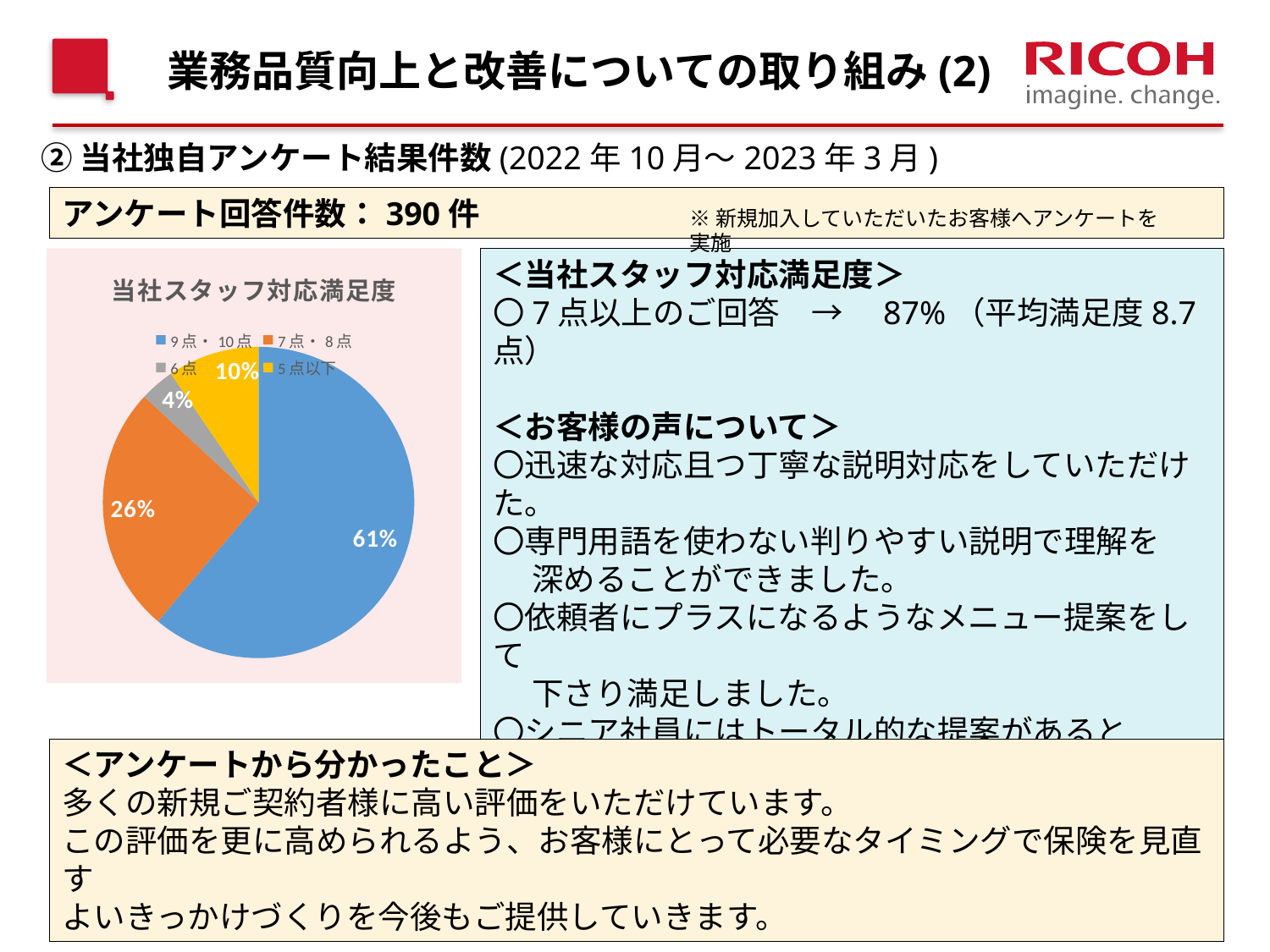
What share of the pie does the 9点・10点 slice represent? 61% Which slice is larger, 5点以下 or 6点? 5点以下 What share of the pie does the 7点・8点 slice represent? 26% What kind of chart is shown on the slide? pie chart What is the difference in percentage points between the 9点・10点 slice and the 7点・8点 slice? 35 What share of the pie does the 5点以下 slice represent? 10% How many categories does the pie chart legend list? 4 What share of the pie does the 6点 slice represent? 4% What is the combined share of the 9点・10点 and 7点・8点 slices? 87% What is the title of the pie chart? 当社スタッフ対応満足度 Which category has the smallest slice of the pie? 6点 Which category has the largest slice of the pie? 9点・10点